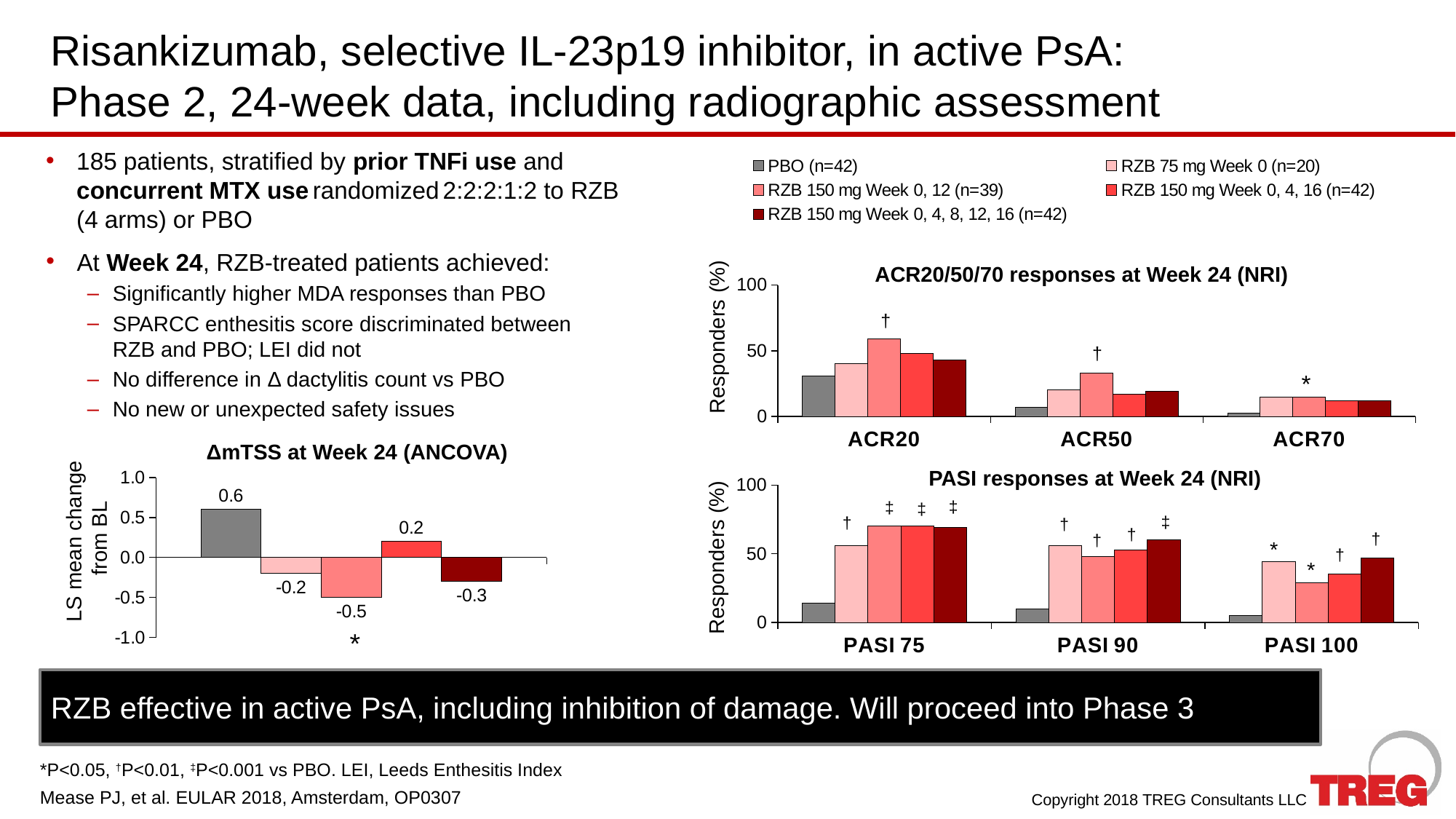
In the ΔmTSS at Week 24 (ANCOVA) chart, what is the LS mean change from BL for PBO? 0.6 In the ACR20/50/70 responses at Week 24 (NRI) chart, is the PBO value for ACR20 greater or less than 50? less What type of chart is the PASI responses at Week 24 (NRI) chart? bar chart In the ΔmTSS at Week 24 (ANCOVA) chart, what is the value for RZB 150 mg Week 0, 12? -0.5 In the ACR20/50/70 responses at Week 24 (NRI) chart, is the RZB 150 mg Week 0, 12 value for ACR20 greater or less than 50? greater How many series does the legend list for the ACR20/50/70 and PASI response charts? 5 In the ΔmTSS at Week 24 (ANCOVA) chart, which treatment arm has the lowest value? RZB 150 mg Week 0, 12 (n=39) How many bars are plotted in the ΔmTSS at Week 24 (ANCOVA) chart? 5 In the ACR20/50/70 responses at Week 24 (NRI) chart, which is larger for PBO: the ACR20 response or the ACR50 response? ACR20 In the ΔmTSS at Week 24 (ANCOVA) chart, which treatment arm has the highest value? PBO (n=42) In the ΔmTSS at Week 24 (ANCOVA) chart, what is the difference between the PBO value and the RZB 150 mg Week 0, 12 value? 1.1 In the PASI responses at Week 24 (NRI) chart, is the RZB 150 mg Week 0, 12 value for PASI 75 greater or less than 50? greater